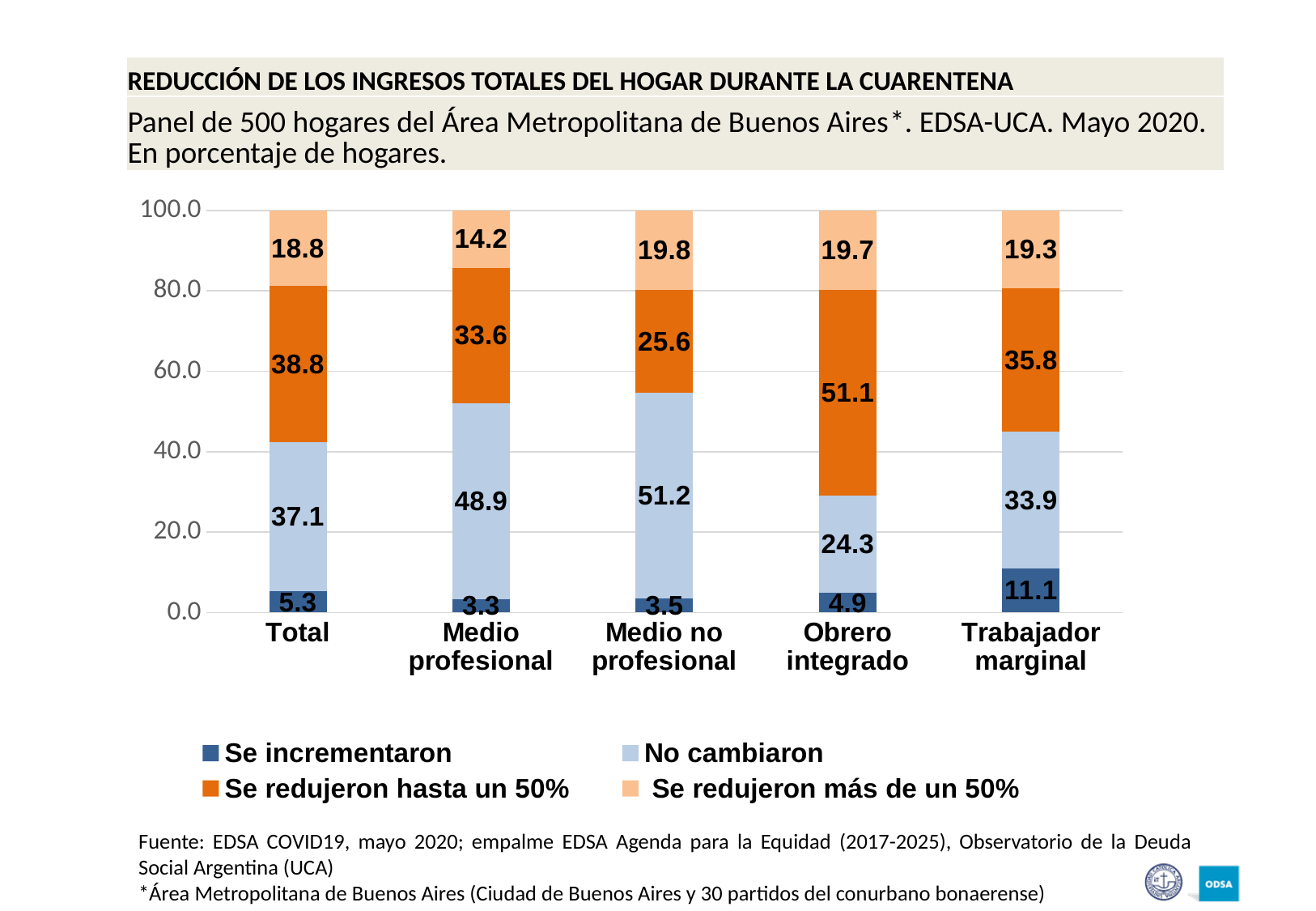
What kind of chart is shown on the slide? Stacked bar chart Which has a larger 'No cambiaron' value, Medio profesional or Trabajador marginal? Medio profesional How many categories are shown on the x axis? 5 How many series does the legend list? 4 What is the value of 'No cambiaron' for Medio no profesional? 51.2 What is the value of 'Se redujeron hasta un 50%' for Obrero integrado? 51.1 Which category has the highest value for 'Se incrementaron'? Trabajador marginal Which category has the lowest value for 'No cambiaron'? Obrero integrado What is the value of 'Se incrementaron' for Trabajador marginal? 11.1 What is the difference between the 'Se redujeron hasta un 50%' values for Obrero integrado and Medio no profesional? 25.5 What is the value of 'Se redujeron más de un 50%' for Total? 18.8 Which category has the lowest value for 'Se redujeron más de un 50%'? Medio profesional